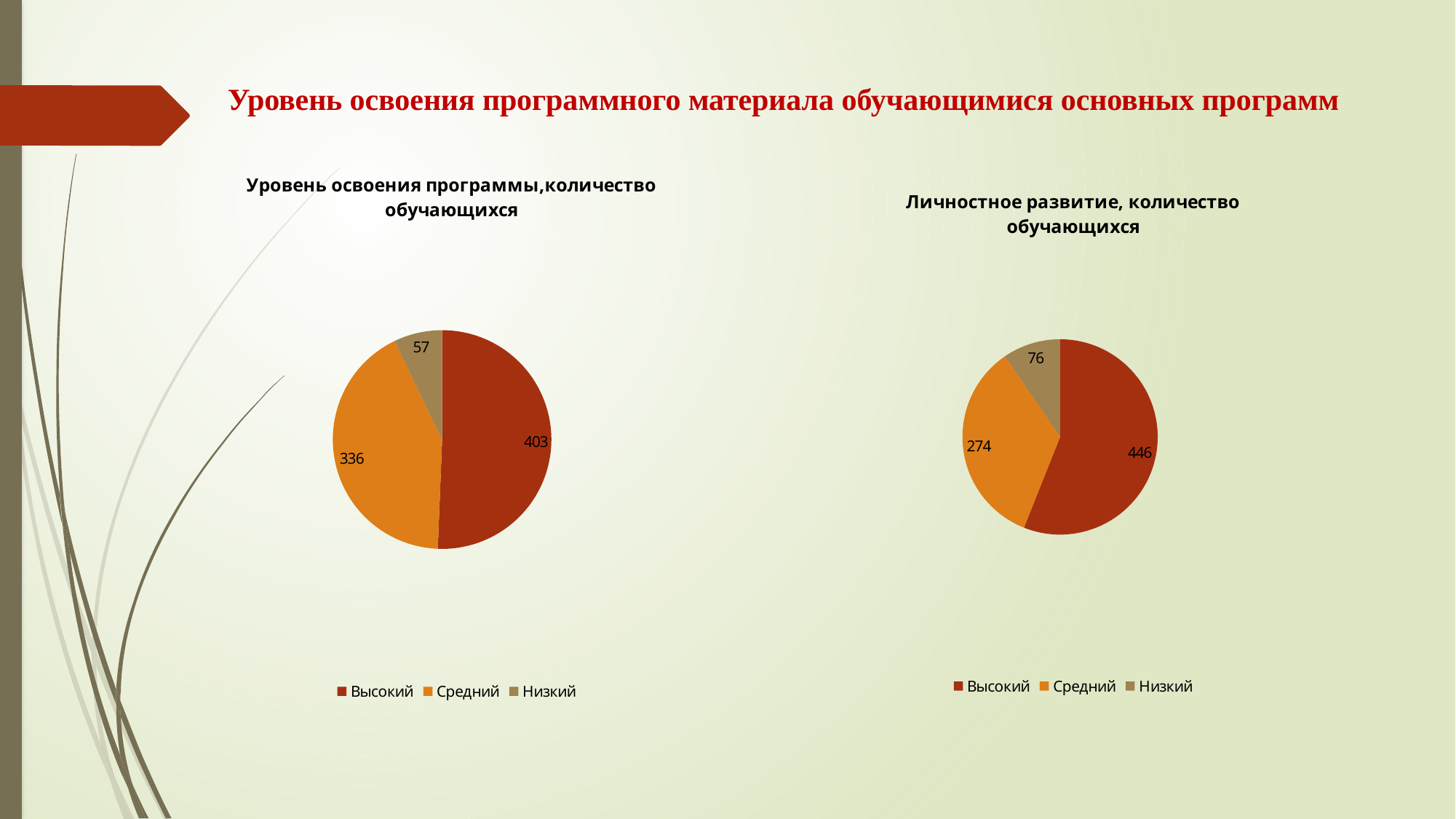
How many categories does the legend of the right chart (Личностное развитие) list? 3 In the left chart (Уровень освоения программы, количество обучающихся), what is the value for Низкий? 57 In the right chart (Личностное развитие, количество обучающихся), what is the value for Средний? 274 In the right chart (Личностное развитие), which category has the smallest slice? Низкий Which is larger: the Средний value in the left chart or the Средний value in the right chart? The left chart (336) What is the total of all slices in the left chart (Уровень освоения программы)? 796 In the right chart (Личностное развитие, количество обучающихся), what is the value for Высокий? 446 In the left chart (Уровень освоения программы, количество обучающихся), what is the value for Высокий? 403 In the left chart (Уровень освоения программы), which category has the largest slice? Высокий What type of chart is used on this slide? Pie chart In the right chart (Личностное развитие), what is the difference between the Высокий and Низкий values? 370 In the left chart (Уровень освоения программы), what is the difference between the Высокий and Средний values? 67